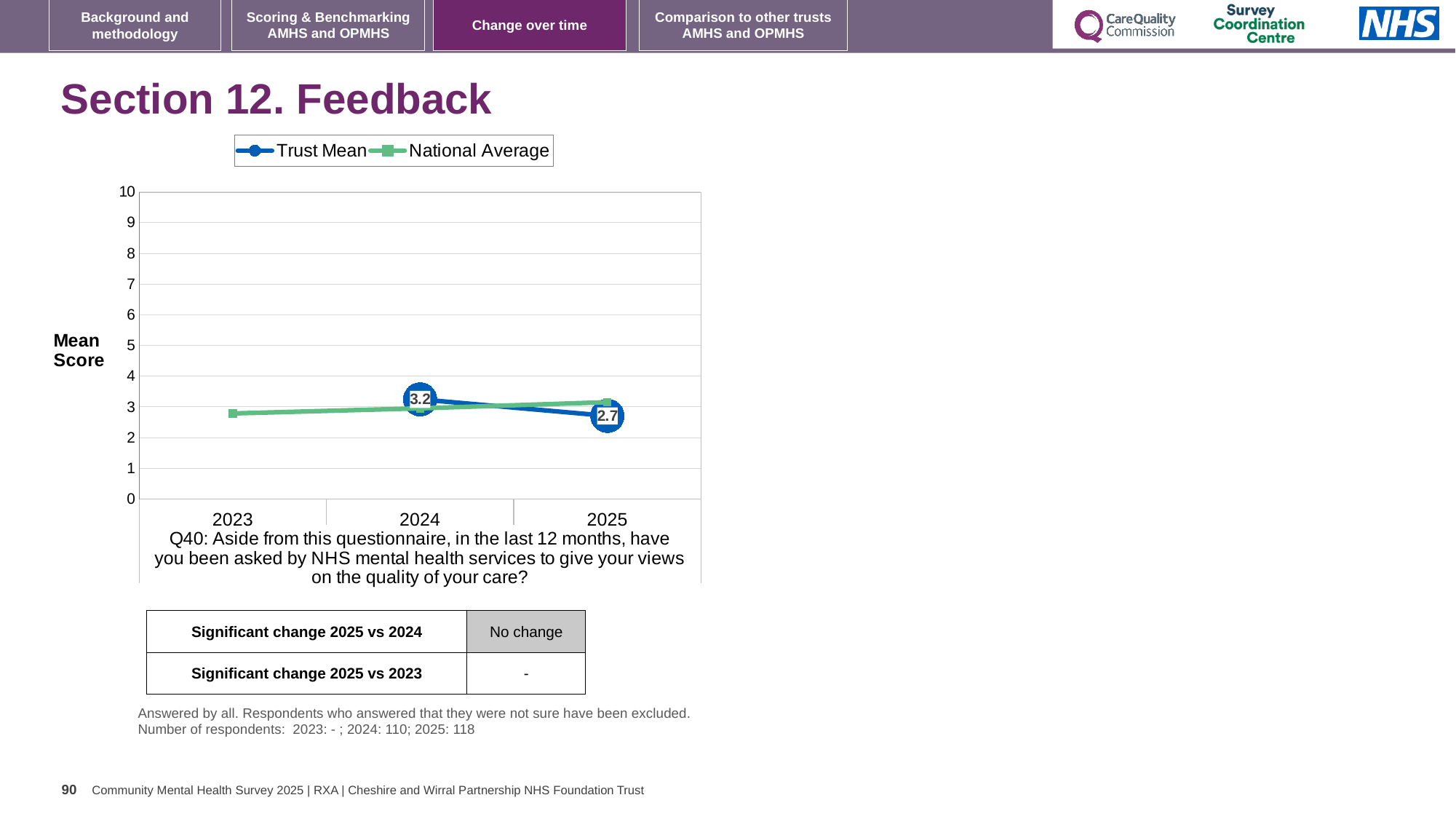
How many years are shown on the x axis? 3 In which year is the Trust Mean at its highest? 2024 Which year has the higher Trust Mean value, 2024 or 2025? 2024 What is the Trust Mean value for 2024? 3.2 Does the Trust Mean rise or fall from 2024 to 2025? fall What is the difference between the Trust Mean values for 2024 and 2025? 0.5 Is the National Average value for 2023 greater or less than 5? less What is the label on the y axis of the chart? Mean Score Is the National Average value for 2025 greater or less than 6? less What kind of chart is shown on the slide? line chart How many series does the legend list? 2 What is the Trust Mean value for 2025? 2.7